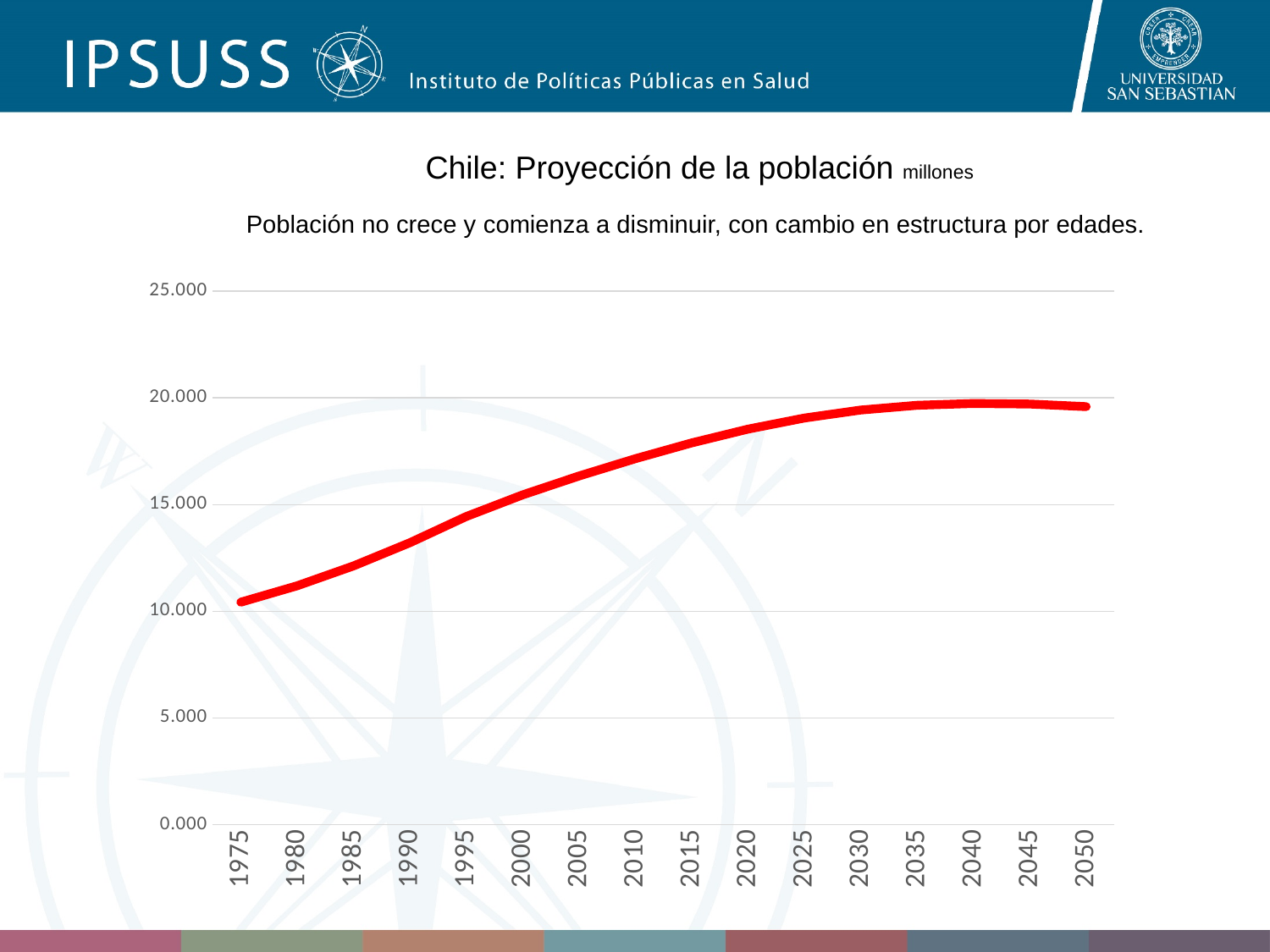
Is the value for 1985 greater or less than 10.000? greater What is the title of the chart? Chile: Proyección de la población Is the value for 2010 greater or less than 15.000? greater What is the highest value labelled on the y axis? 25.000 Is the value for 2020 greater or less than 20.000? less Does the population rise or fall between 1975 and 2020? rise Which is larger, the value for 1980 or the value for 2000? 2000 Which year has the lowest population value on the chart? 1975 How many years are labelled along the x axis? 16 In what units is the population plotted, according to the chart title? millones What kind of chart is shown on the slide? line chart